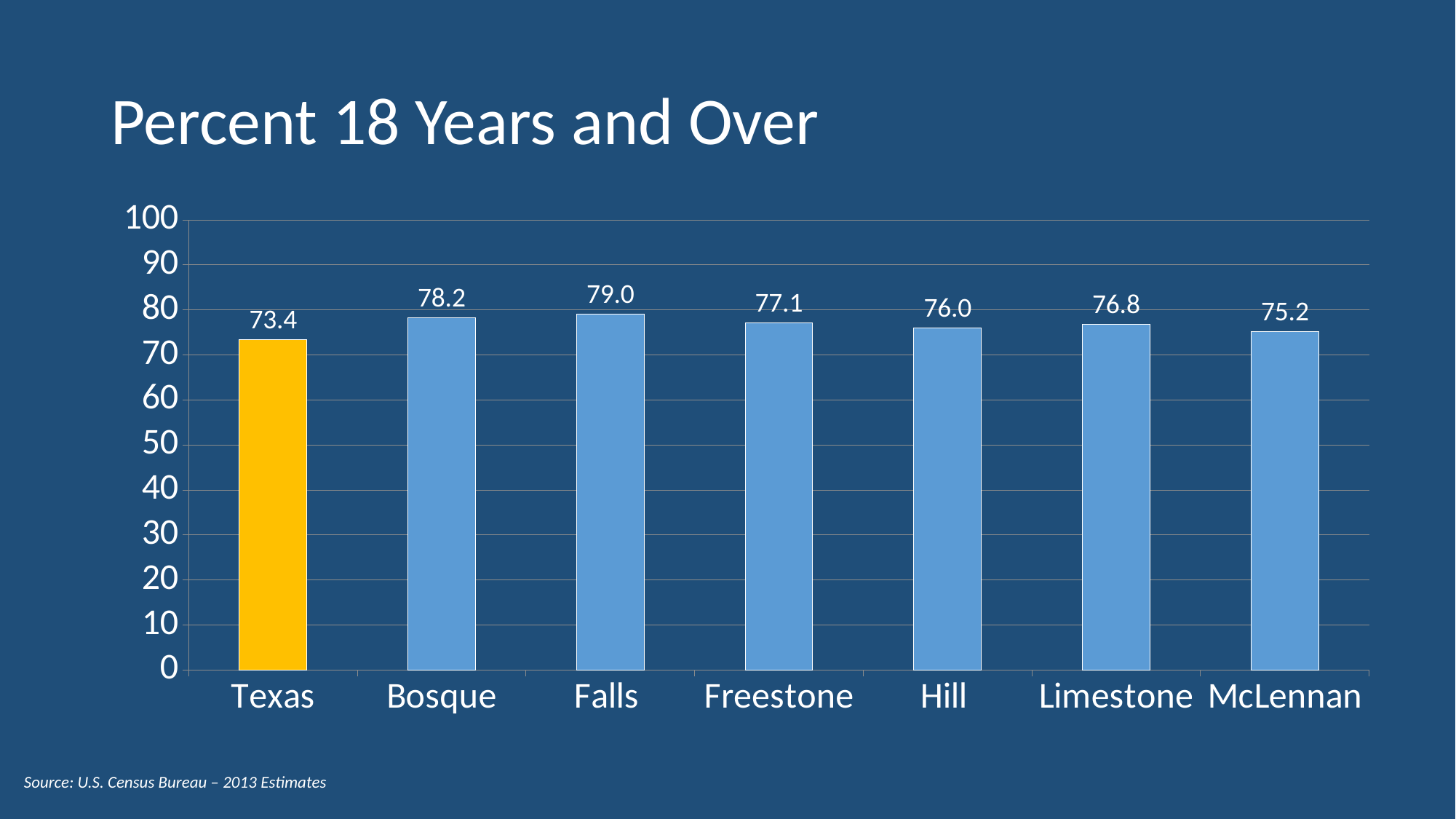
What is the value for Texas? 73.4 What is the difference between the values for Falls and McLennan? 3.8 Is the value for McLennan greater or less than 80? less What is the title of the chart? Percent 18 Years and Over Which is larger, the value for Freestone or the value for Hill? Freestone Which category has the lowest value? Texas What kind of chart is shown on the slide? bar chart What is the value for Falls? 79.0 What is the difference between the values for Bosque and Texas? 4.8 What is the value for Limestone? 76.8 How many categories are shown on the x axis? 7 Which category has the highest value? Falls